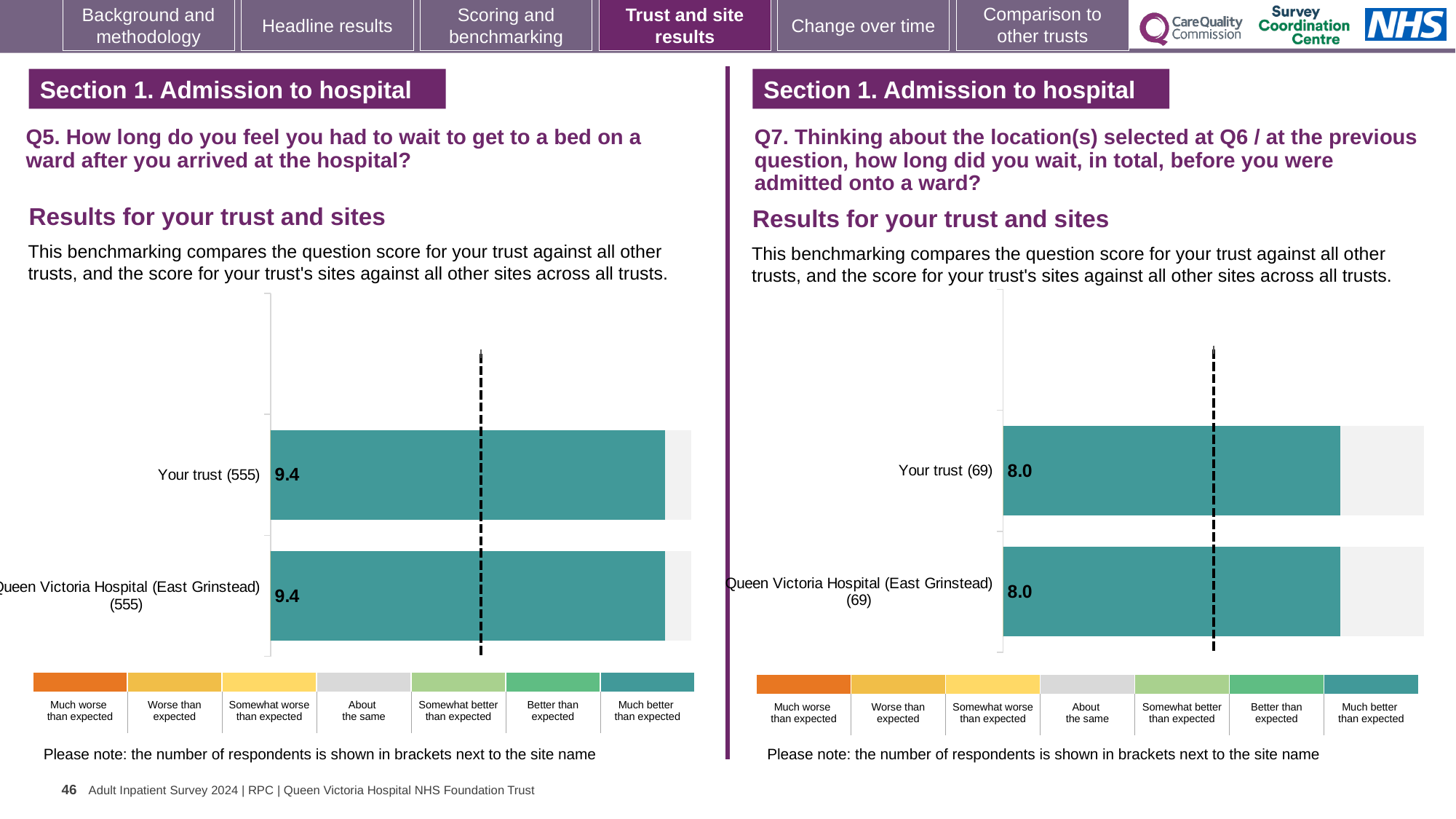
On the left chart (Q5), what is the difference between the score for Your trust and the score for Queen Victoria Hospital (East Grinstead)? 0.0 On the right chart (Q7), what is the difference between the score for Your trust and the score for Queen Victoria Hospital (East Grinstead)? 0.0 On the right chart (Q7), how many respondents are shown in brackets for Queen Victoria Hospital (East Grinstead)? 69 On the right chart (Q7), what is the score for Queen Victoria Hospital (East Grinstead)? 8.0 On the left chart (Q5), what is the score for Your trust? 9.4 On the right chart (Q7), what is the score for Your trust? 8.0 How many bars are plotted on the left chart (Q5)? 2 On the left chart (Q5), how many respondents are shown in brackets for Your trust? 555 How many categories does the colour key below the right chart (Q7) list? 7 On the left chart (Q5), what is the score for Queen Victoria Hospital (East Grinstead)? 9.4 What kind of chart is used on the left (Q5)? Bar chart How many bars are plotted on the right chart (Q7)? 2